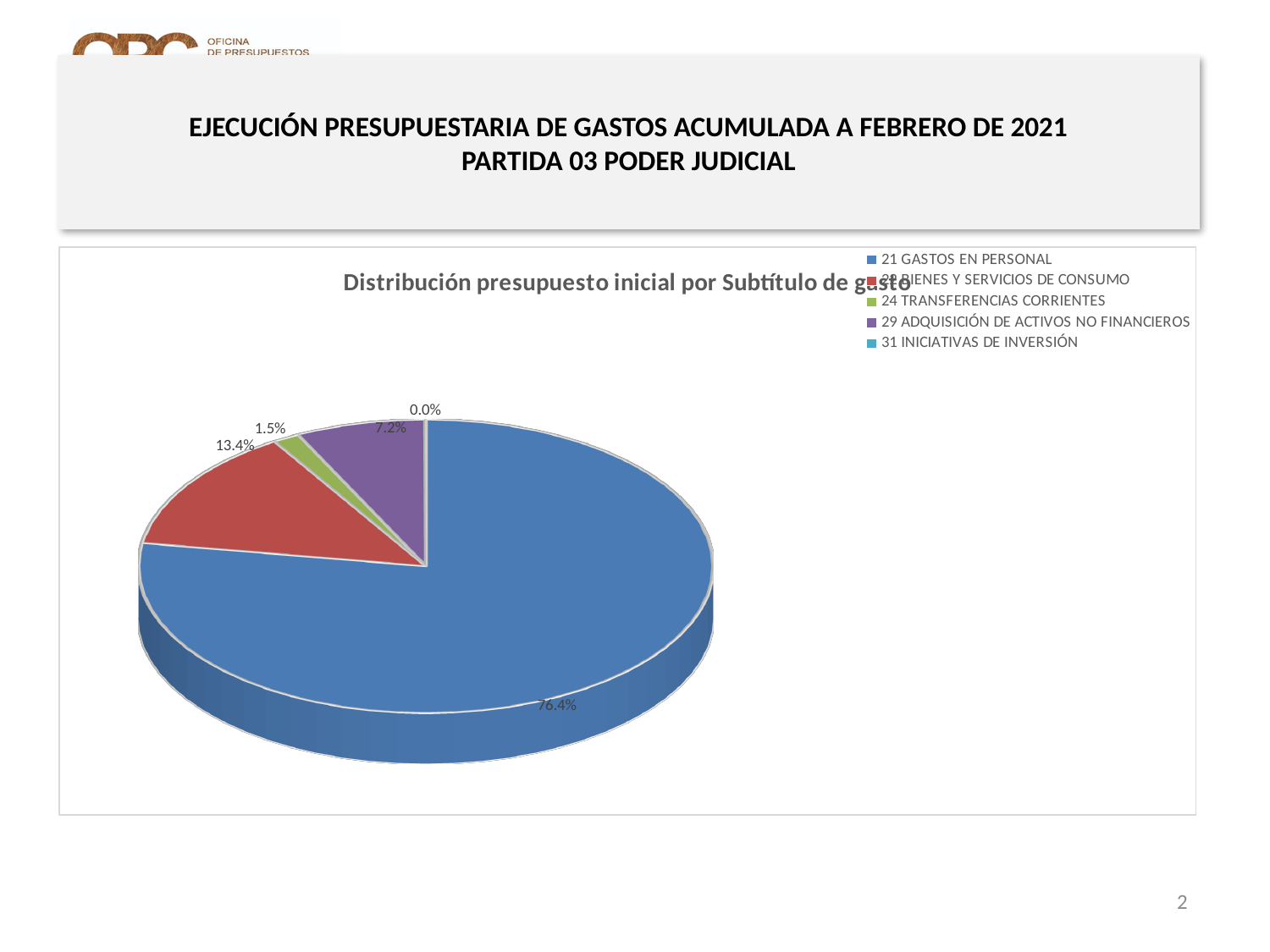
How many categories does the legend list? 5 What share of the pie does 29 ADQUISICIÓN DE ACTIVOS NO FINANCIEROS have? 7.2% What share of the pie does 24 TRANSFERENCIAS CORRIENTES have? 1.5% Which category has the smallest share of the pie? 31 INICIATIVAS DE INVERSIÓN What share of the pie does 21 GASTOS EN PERSONAL have? 76.4% What kind of chart is shown on the slide? Pie chart What is the title of the chart? Distribución presupuesto inicial por Subtítulo de gasto Which has the larger share: 29 ADQUISICIÓN DE ACTIVOS NO FINANCIEROS or 24 TRANSFERENCIAS CORRIENTES? 29 ADQUISICIÓN DE ACTIVOS NO FINANCIEROS What percentage is shown for the red slice of the pie? 13.4% Which category has the largest share of the pie? 21 GASTOS EN PERSONAL What is the difference in percentage points between 21 GASTOS EN PERSONAL and 29 ADQUISICIÓN DE ACTIVOS NO FINANCIEROS? 69.2 percentage points